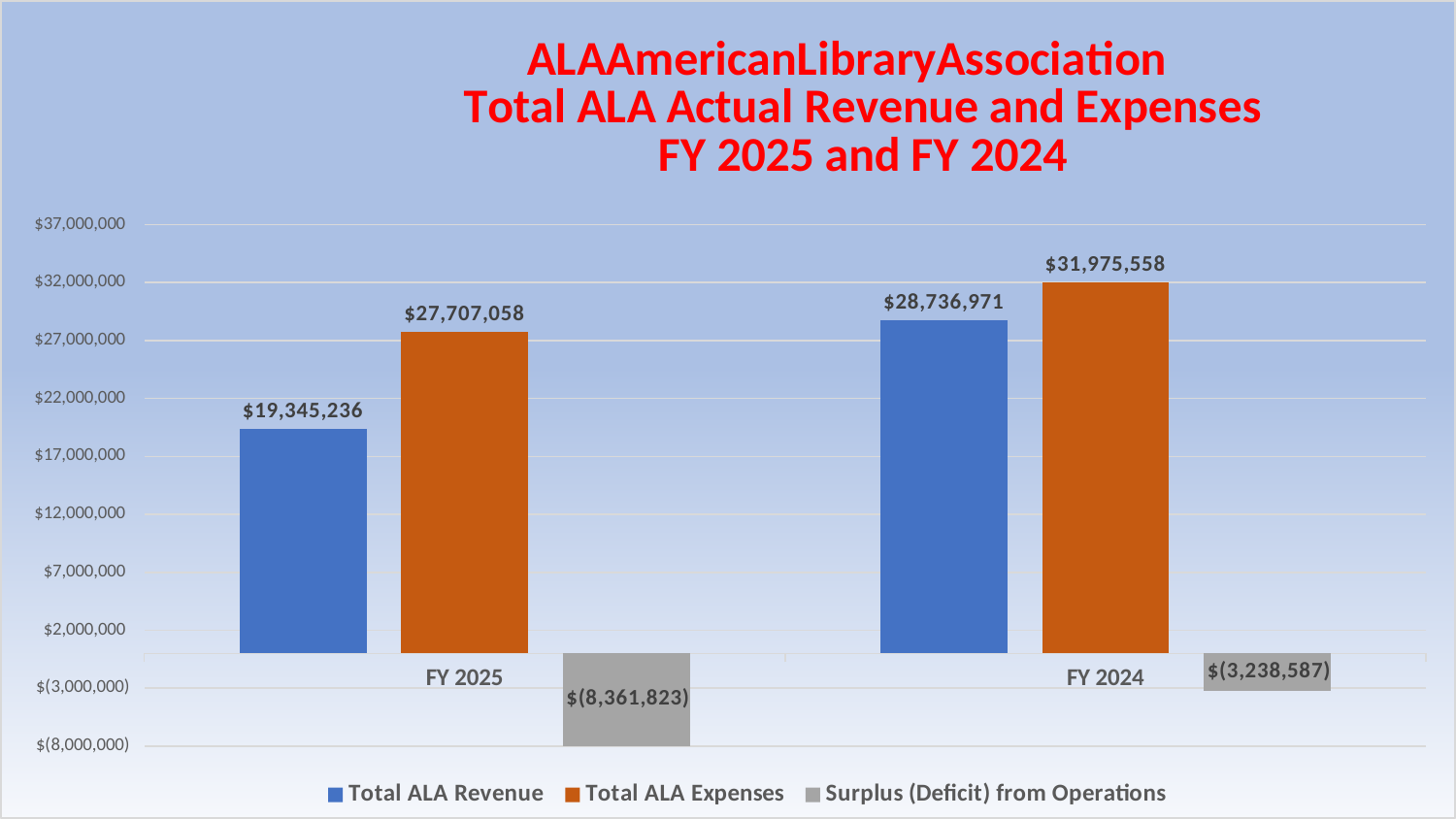
What is the Total ALA Revenue for FY 2025? $19,345,236 What kind of chart is shown on the slide? Bar chart What is the difference between Total ALA Revenue in FY 2024 and FY 2025? $9,391,735 What is the Surplus (Deficit) from Operations for FY 2024? $(3,238,587) How many series does the legend list? 3 What colour represents Total ALA Expenses in the chart? Orange Which bar on the chart has the lowest value? Surplus (Deficit) from Operations for FY 2025 What is the Total ALA Expenses value for FY 2024? $31,975,558 What is the Surplus (Deficit) from Operations for FY 2025? $(8,361,823) How much higher are Total ALA Expenses in FY 2024 than in FY 2025? $4,268,500 In FY 2025, which is larger: Total ALA Revenue or Total ALA Expenses? Total ALA Expenses Which fiscal year has the higher Total ALA Revenue? FY 2024